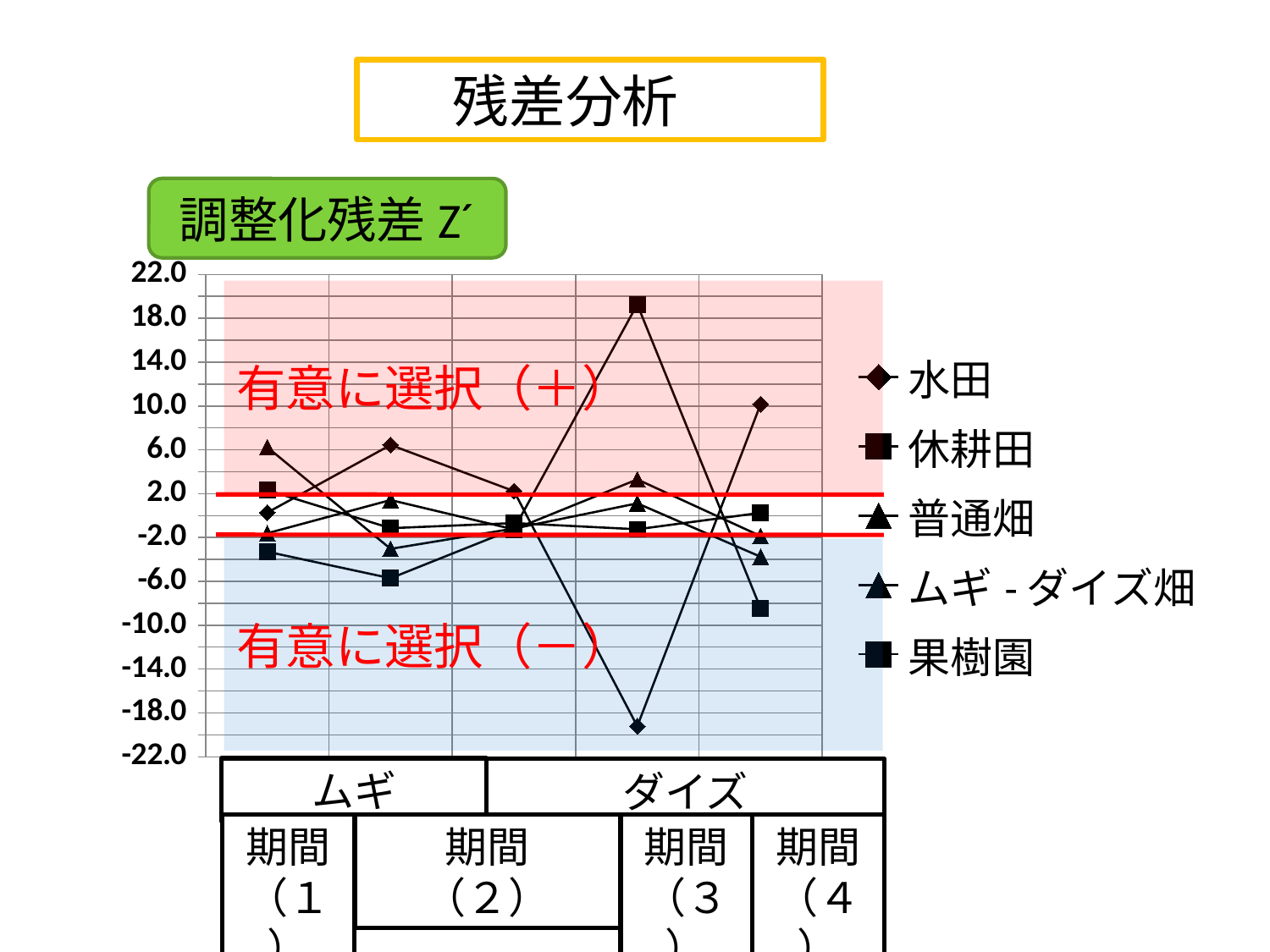
What label is written in the red shaded upper region of the chart? 有意に選択（＋） Is the value for 休耕田 at 期間(3) greater or less than 18.0? greater At 期間(3), which is larger: the value for 休耕田 or the value for 水田? 休耕田 Is the value for 水田 at 期間(3) greater or less than -18.0? less Is the value for 果樹園 at 期間(4) greater or less than -6.0? greater How many series does the legend list? 5 Which series reaches the highest value on the chart? 休耕田 At 期間(4), which is larger: the value for 水田 or the value for 果樹園? 水田 Does the value for 休耕田 rise or fall from 期間(3) to 期間(4)? fall What kind of chart is shown on the slide? line chart Which series reaches the lowest value on the chart? 水田